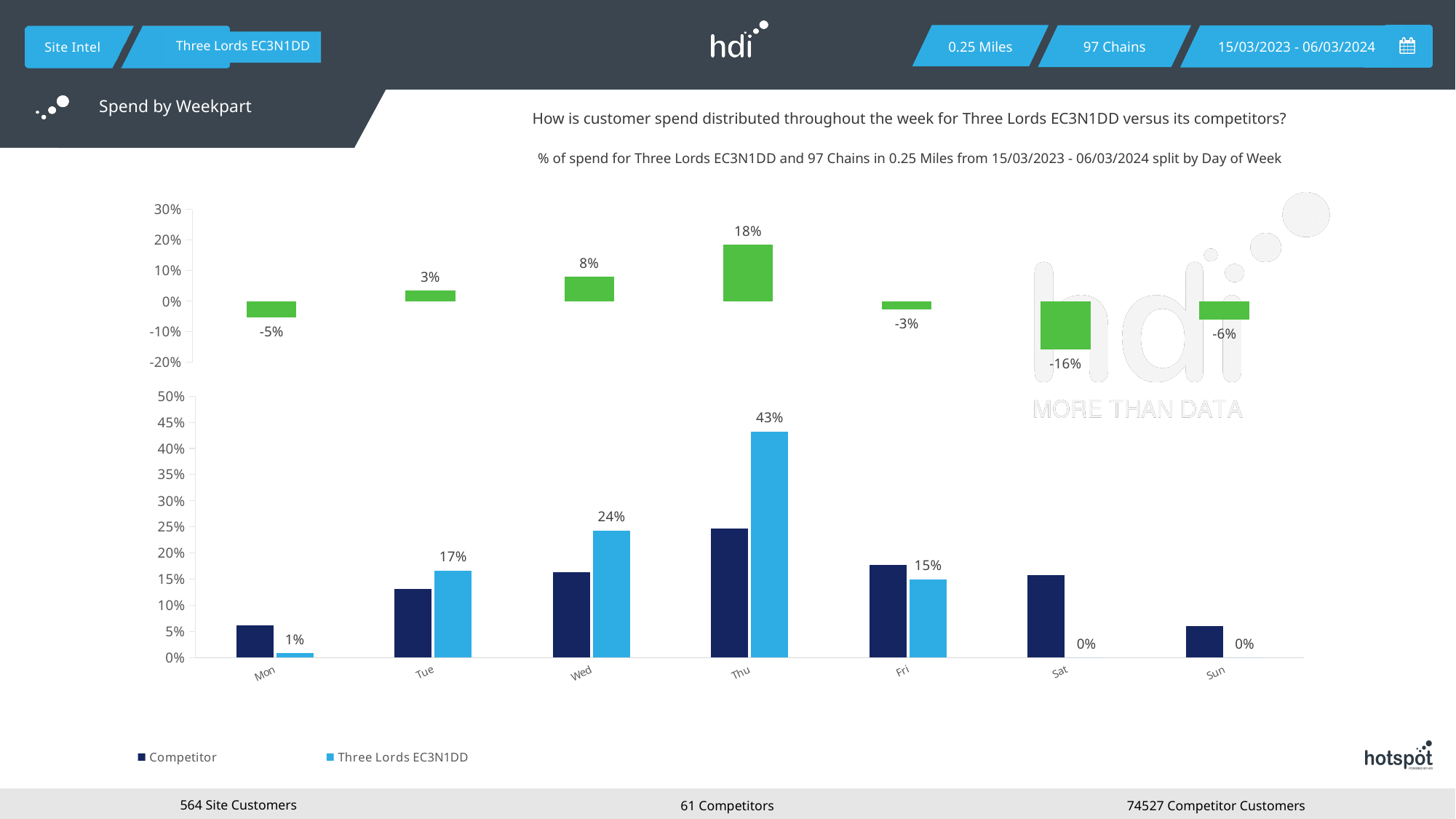
In the bottom chart, what is the value for Three Lords EC3N1DD on Wed? 24% In the bottom chart, is the Competitor value for Thu greater or less than 20%? greater In the bottom chart, is the Competitor value for Mon greater or less than 10%? less How many series does the legend of the bottom chart list? 2 In the bottom chart, what is the value for Three Lords EC3N1DD on Thu? 43% In the top chart, what is the value shown for Thu? 18% In the top chart, which day has the lowest value? Sat In the bottom chart, on Fri, which is larger: the Competitor bar or the Three Lords EC3N1DD bar? Competitor How many days of the week are shown on the x axis of the bottom chart? 7 In the bottom chart, what is the difference between the Three Lords EC3N1DD values for Thu and Wed? 19% In the bottom chart, which day has the highest value for Three Lords EC3N1DD? Thu In the top chart, what is the value shown for Sat? -16%